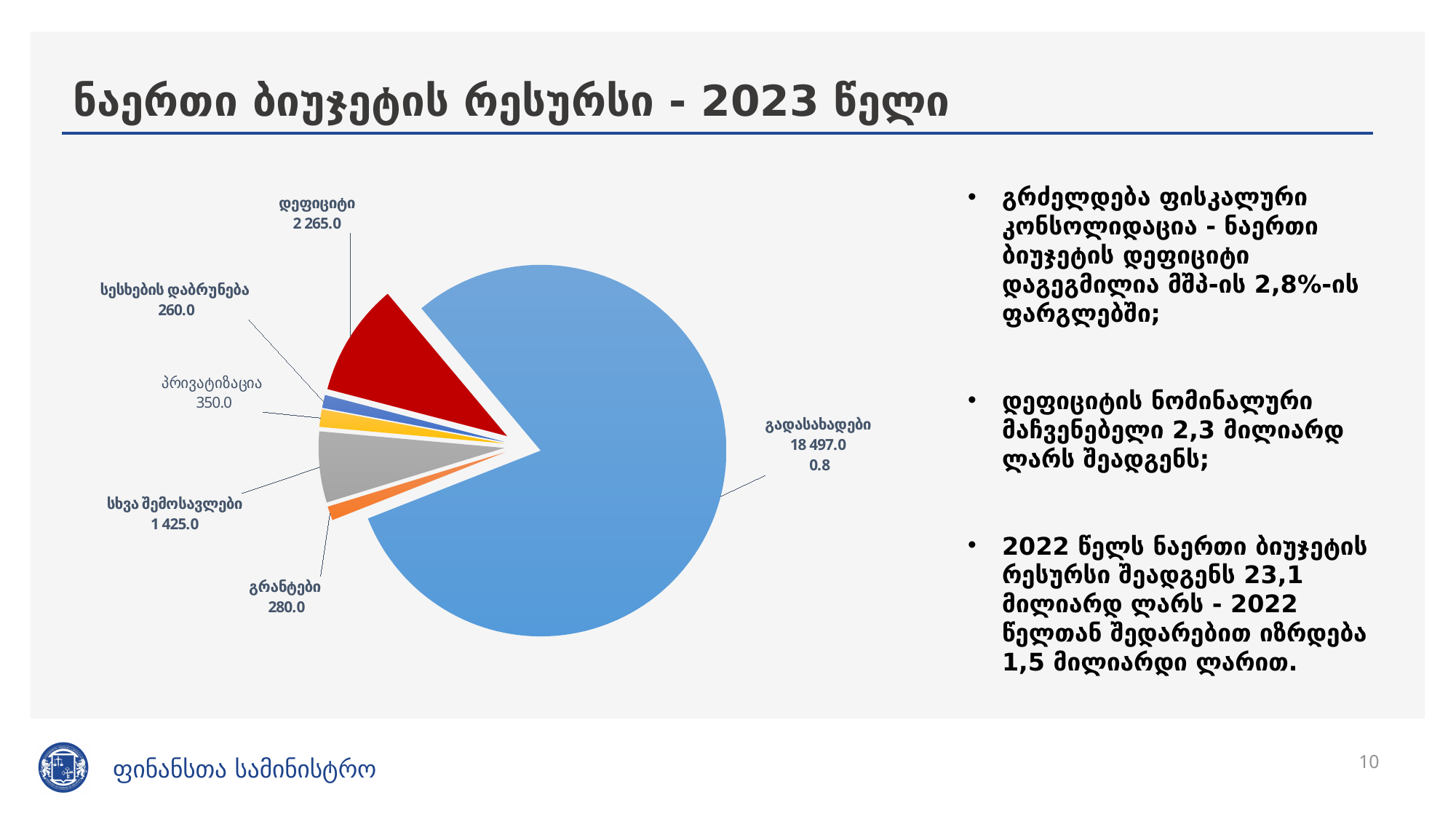
Which category has the largest slice in the pie chart? გადასახადები What is the title of the slide containing the chart? ნაერთი ბიუჯეტის რესურსი - 2023 წელი What type of chart is shown on the slide? Pie chart What is the value shown for გრანტები in the pie chart? 280.0 What is the value shown for სხვა შემოსავლები in the pie chart? 1 425.0 What is the value shown for პრივატიზაცია in the pie chart? 350.0 What is the value shown for გადასახადები in the pie chart? 18 497.0 What is the value shown for სესხების დაბრუნება in the pie chart? 260.0 Which is larger, the value for პრივატიზაცია or the value for გრანტები? პრივატიზაცია What is the value shown for დეფიციტი in the pie chart? 2 265.0 Which of the labeled categories has the smallest value in the pie chart? სესხების დაბრუნება What is the difference between the values for დეფიციტი and სხვა შემოსავლები? 840.0